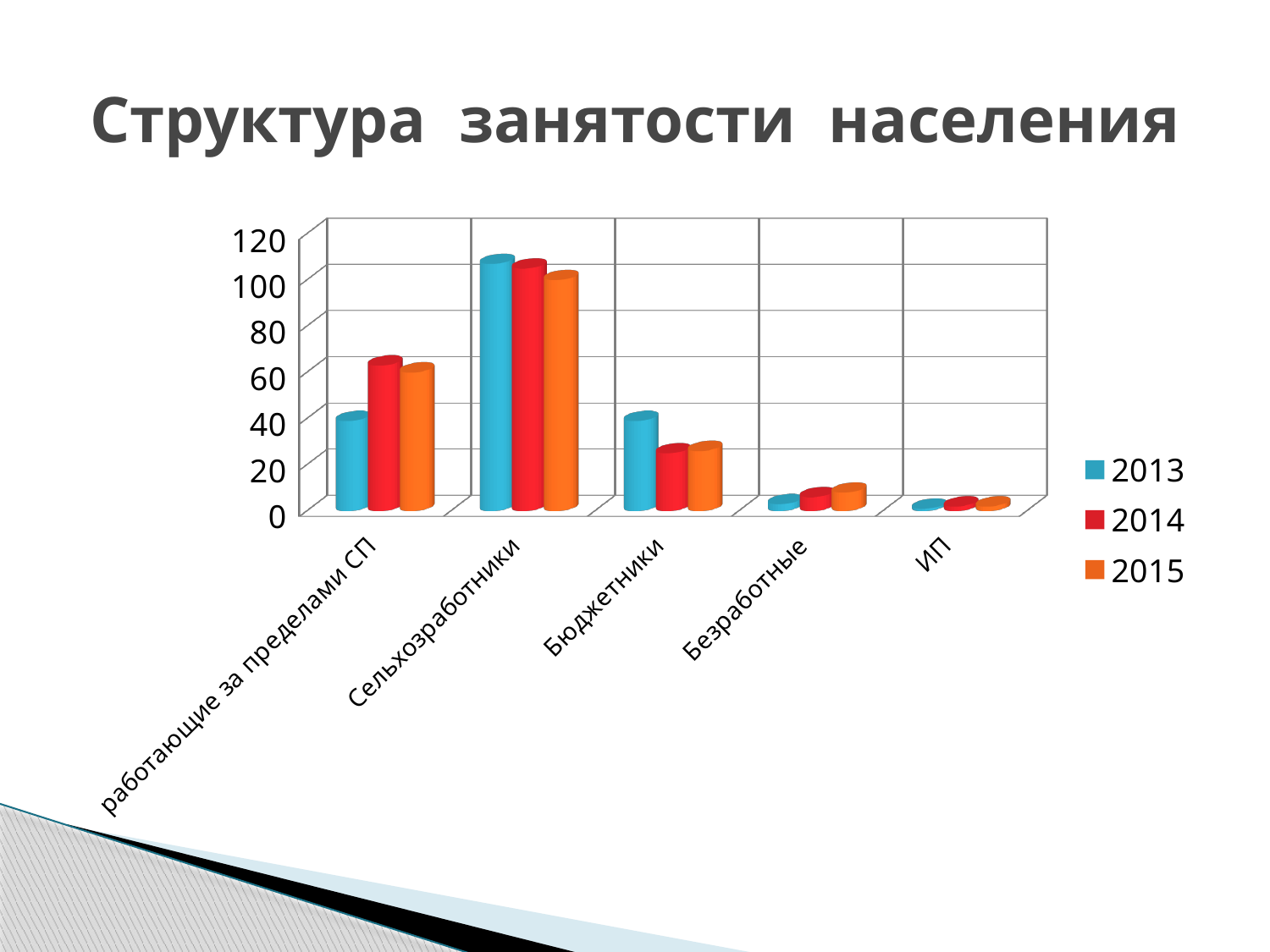
What kind of chart is shown on the slide? bar chart For Бюджетники, which is larger: the 2013 value or the 2014 value? 2013 What is the title of the chart on the slide? Структура занятости населения How many series does the legend list? 3 How many categories are shown on the x axis of the chart? 5 Is the 2013 value for Сельхозработники greater or less than 100? greater Is the 2014 value for Бюджетники greater or less than 40? less For работающие за пределами СП, which is larger: the 2013 value or the 2014 value? 2014 Is the 2015 value for Безработные greater or less than 20? less Which category has the highest value for 2013? Сельхозработники Which category has the lowest value for 2015? ИП